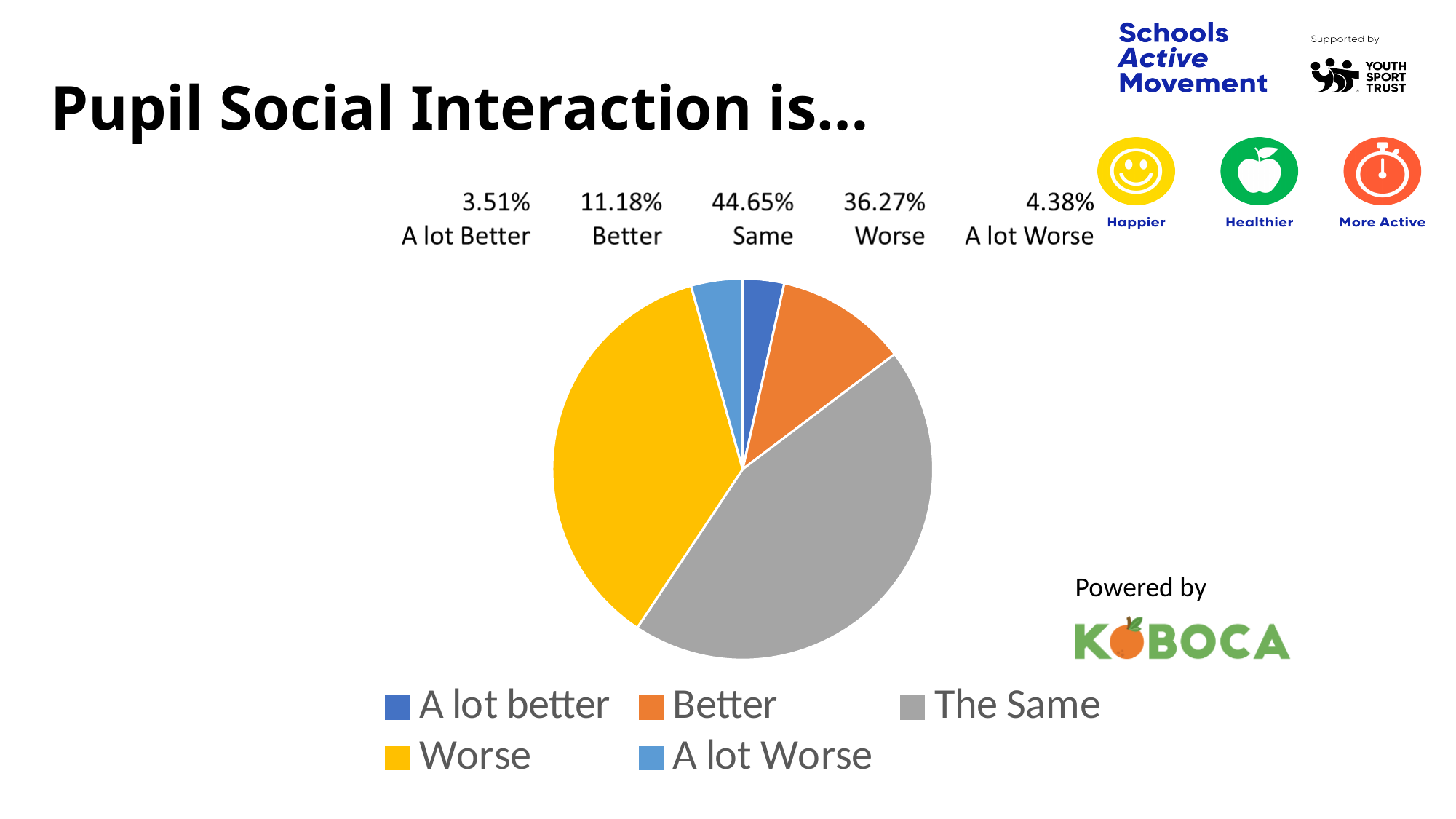
What percentage of responses say pupil social interaction is Worse? 36.27% What percentage of responses say pupil social interaction is A lot Worse? 4.38% What percentage of responses say pupil social interaction is the Same? 44.65% What type of chart is shown on the slide? Pie chart What colour is the slice for The Same in the pie chart? Grey How many categories are shown in the pie chart? 5 Which category has the smallest share of the pie? A lot Better Which category has the largest share of the pie? Same What percentage of responses say pupil social interaction is Better? 11.18% Which is larger, the share for A lot Worse or the share for A lot Better? A lot Worse What is the difference in percentage points between the Same and Worse categories? 8.38% What percentage of responses say pupil social interaction is A lot Better? 3.51%